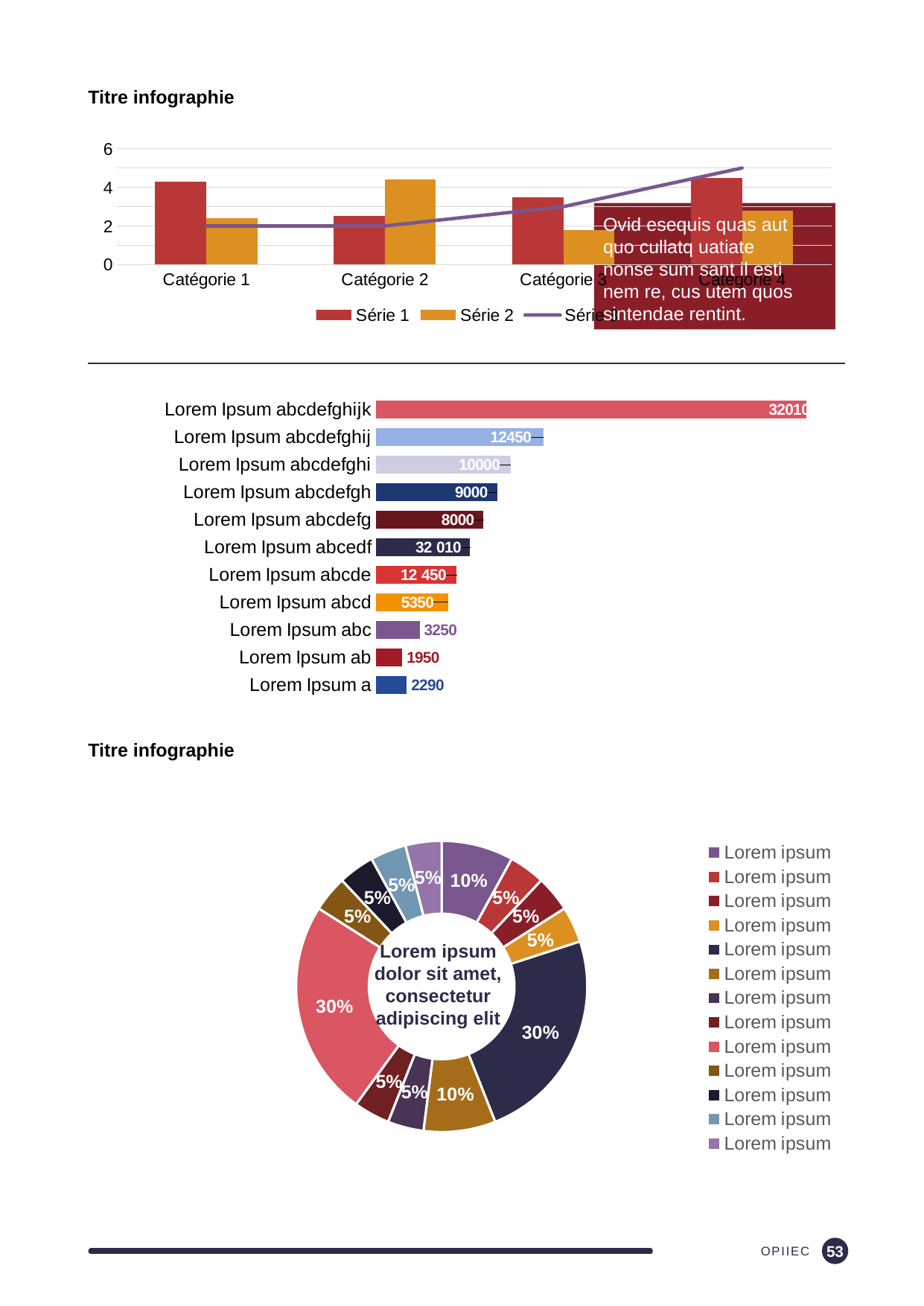
What kind of chart is the top chart on the slide? bar chart with a line In the top chart, how many categories are shown on the x axis? 4 In the middle horizontal bar chart, what is the value for Lorem Ipsum abcd? 5350 In the top chart, how many series does the legend list? 3 In the middle horizontal bar chart, what is the value for Lorem Ipsum a? 2290 In the middle horizontal bar chart, how many categories are listed? 11 In the bottom doughnut chart, how many entries does the legend list? 13 In the top chart, is the Série 2 value for Catégorie 2 greater or less than 4? greater In the top chart, which series has the larger bar for Catégorie 1, Série 1 or Série 2? Série 1 In the top chart, does the Série 3 line rise or fall from Catégorie 1 to Catégorie 4? rise In the top chart, is the Série 1 value for Catégorie 1 greater or less than 4? greater In the middle horizontal bar chart, what is the difference between the values for Lorem Ipsum abcdefgh and Lorem Ipsum abcdefg? 1000